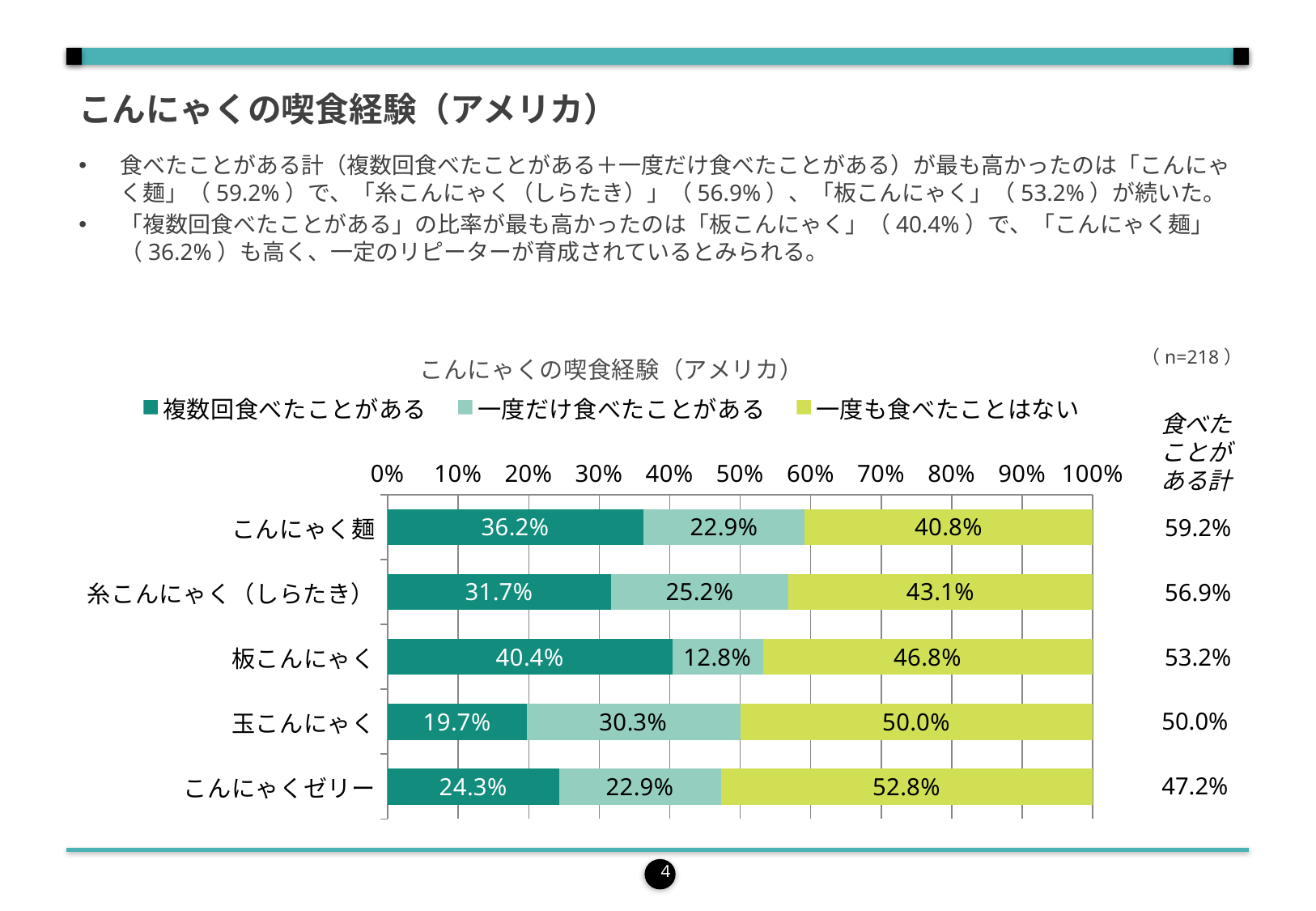
Which category has the highest value for 複数回食べたことがある? 板こんにゃく Which is larger: the 一度だけ食べたことがある value for 玉こんにゃく or for 板こんにゃく? 玉こんにゃく Which category has the lowest value for 複数回食べたことがある? 玉こんにゃく What type of chart is shown on the slide? bar chart What is the value of 一度だけ食べたことがある for 糸こんにゃく（しらたき）? 25.2% How many series does the legend list? 3 What is the value of 一度も食べたことはない for こんにゃくゼリー? 52.8% What is the 食べたことがある計 value shown for 糸こんにゃく（しらたき）? 56.9% How many categories are plotted in the chart? 5 What is the value of 複数回食べたことがある for こんにゃく麺? 36.2% What is the title of the chart? こんにゃくの喫食経験（アメリカ） What is the difference between the 一度も食べたことはない values for 板こんにゃく and こんにゃく麺? 6.0%